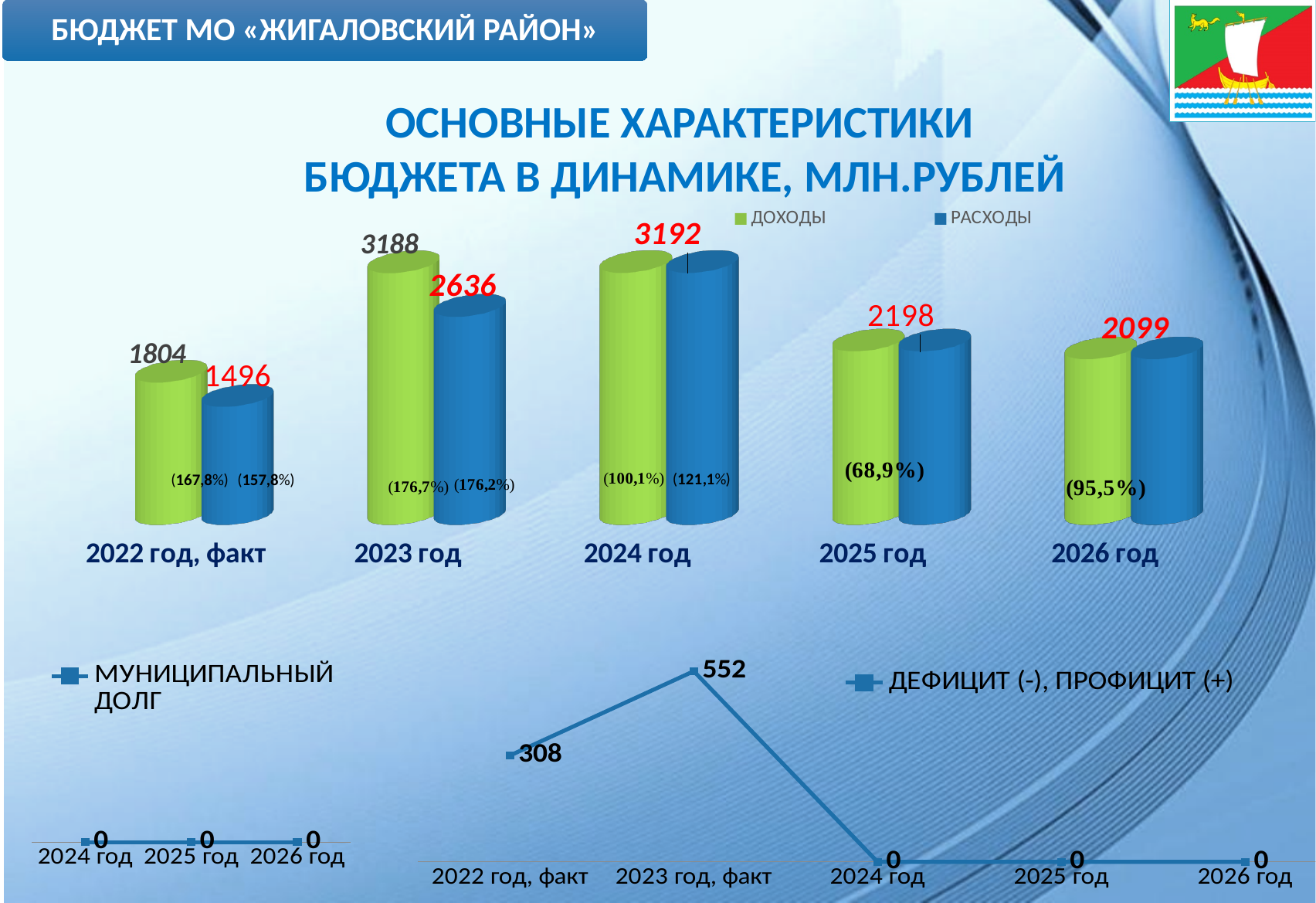
In the bottom-right chart ДЕФИЦИТ (-), ПРОФИЦИТ (+), what is the value for 2023 год, факт? 552 In the bottom-right chart ДЕФИЦИТ (-), ПРОФИЦИТ (+), which year has the highest value? 2023 год, факт In the top bar chart, what is the difference between ДОХОДЫ and РАСХОДЫ for 2023 год? 552 How many series does the legend of the top chart list? 2 What kind of chart is the top chart on the slide? bar chart In the top bar chart, which is larger for 2022 год, факт: ДОХОДЫ or РАСХОДЫ? ДОХОДЫ In the top bar chart, what is the value of РАСХОДЫ for 2022 год, факт? 1496 In the top bar chart, what is the value of РАСХОДЫ for 2023 год? 2636 How many year categories does the top bar chart show? 5 In the top bar chart, what is the value of ДОХОДЫ for 2022 год, факт? 1804 In the top bar chart, which year has the lowest ДОХОДЫ? 2022 год, факт In the bottom-left chart МУНИЦИПАЛЬНЫЙ ДОЛГ, what is the value for 2025 год? 0